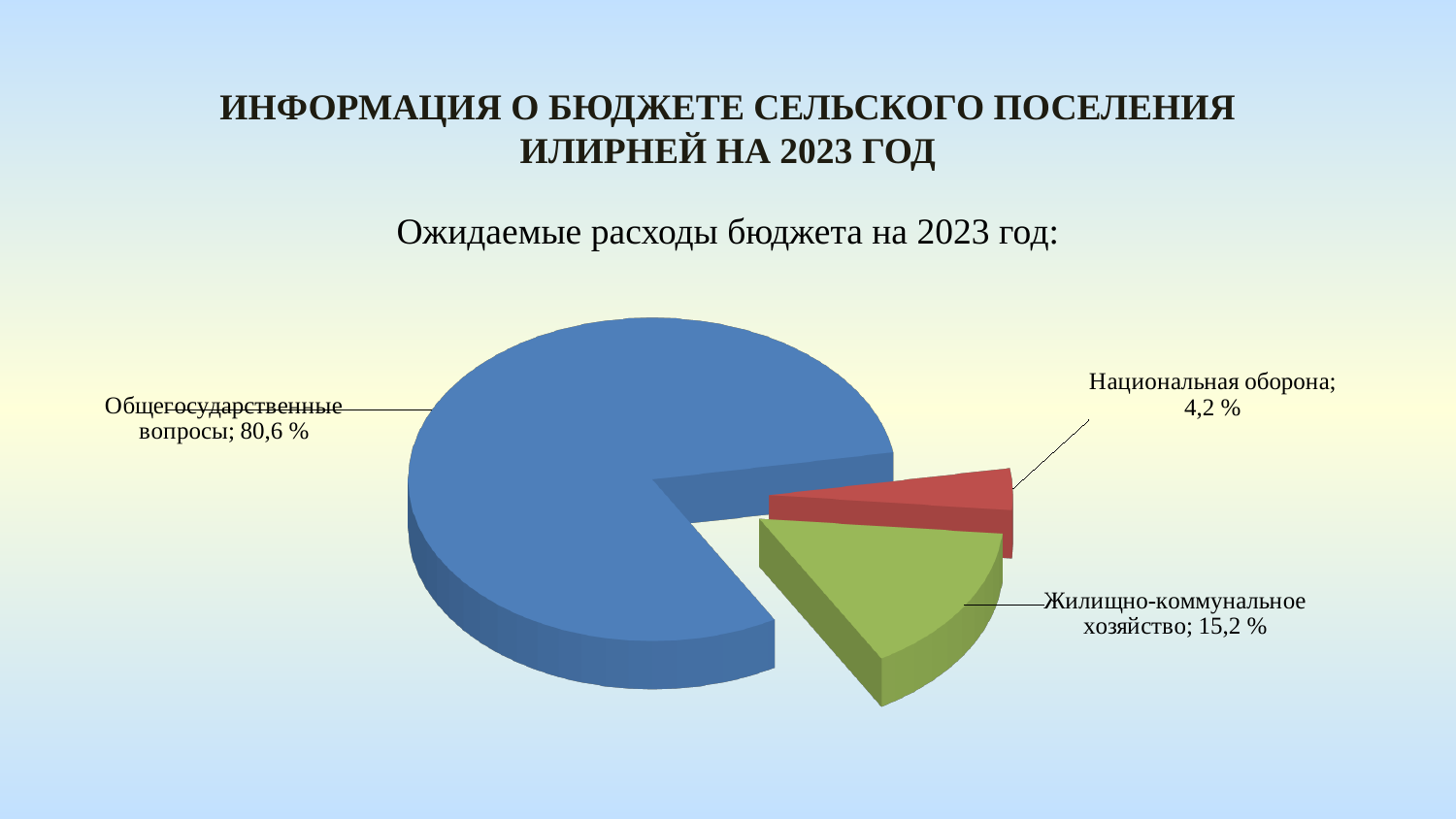
What is the subtitle above the chart? Ожидаемые расходы бюджета на 2023 год: What kind of chart is shown on the slide? Pie chart How many categories are shown in the pie chart? 3 What is the difference in percentage points between Общегосударственные вопросы and Жилищно-коммунальное хозяйство? 65,4 Which category has the largest slice of the pie? Общегосударственные вопросы What share of the pie does Национальная оборона have? 4,2 % What share of the pie does Общегосударственные вопросы have? 80,6 % What is the difference in percentage points between Жилищно-коммунальное хозяйство and Национальная оборона? 11 What share of the pie does Жилищно-коммунальное хозяйство have? 15,2 % Which category has the smallest slice of the pie? Национальная оборона Which is larger: the slice for Жилищно-коммунальное хозяйство or the slice for Национальная оборона? Жилищно-коммунальное хозяйство What colour is the slice for Жилищно-коммунальное хозяйство? Green